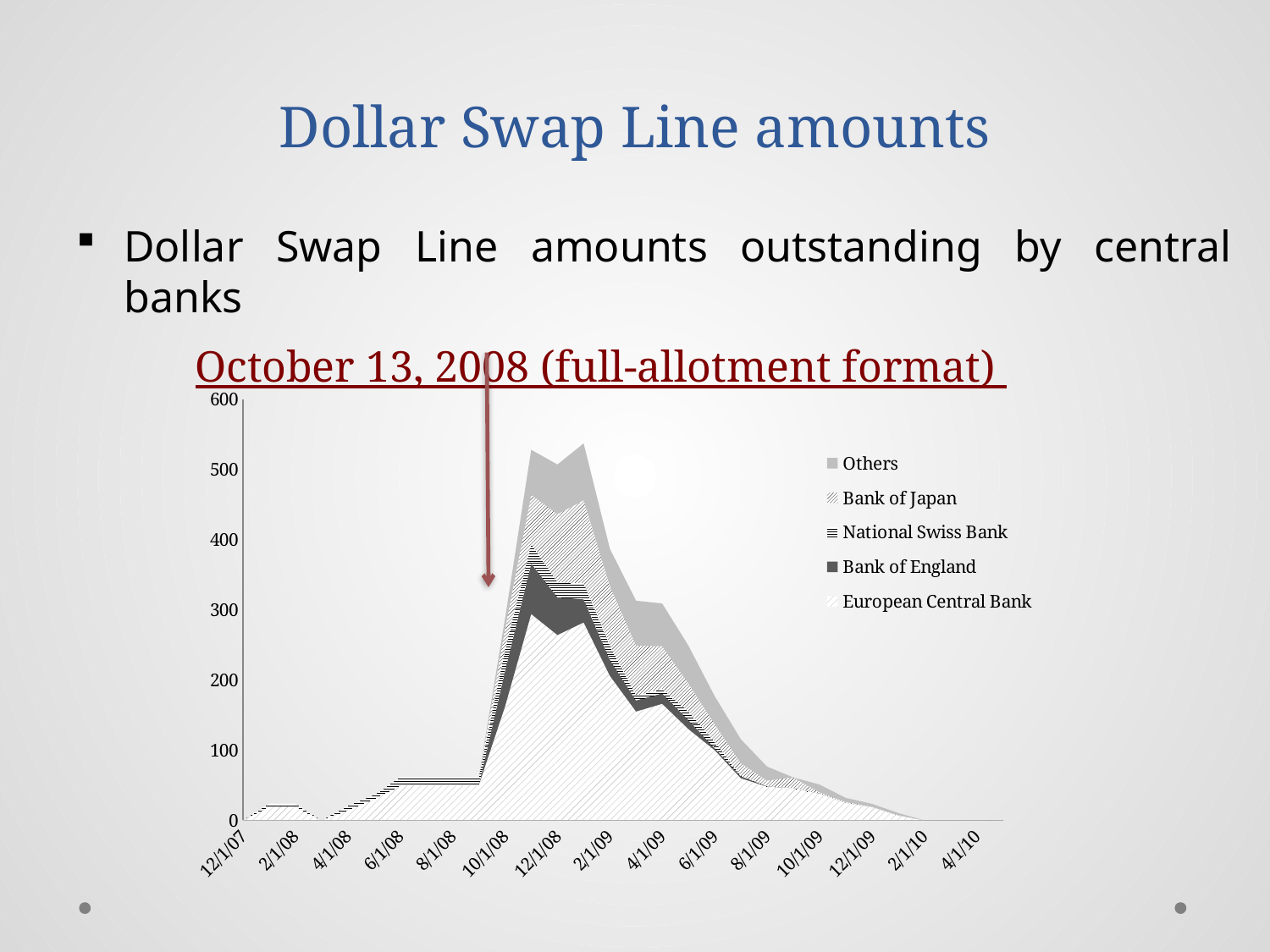
What kind of chart is shown on the slide? Stacked area chart Is the total amount outstanding at 2/1/10 greater or less than 100? less Is the total amount outstanding at 12/1/08 greater or less than 400? greater Is the total amount outstanding at 4/1/09 greater or less than 200? greater Which series forms the bottom layer of the stacked area chart? European Central Bank Which date has a larger total amount outstanding, 12/1/08 or 8/1/09? 12/1/08 Which series is listed first (at the top) in the chart legend? Others How many date labels are shown on the x axis? 15 How do the total amounts outstanding change from 2/1/09 to 2/1/10? They fall How many series does the chart legend list? 5